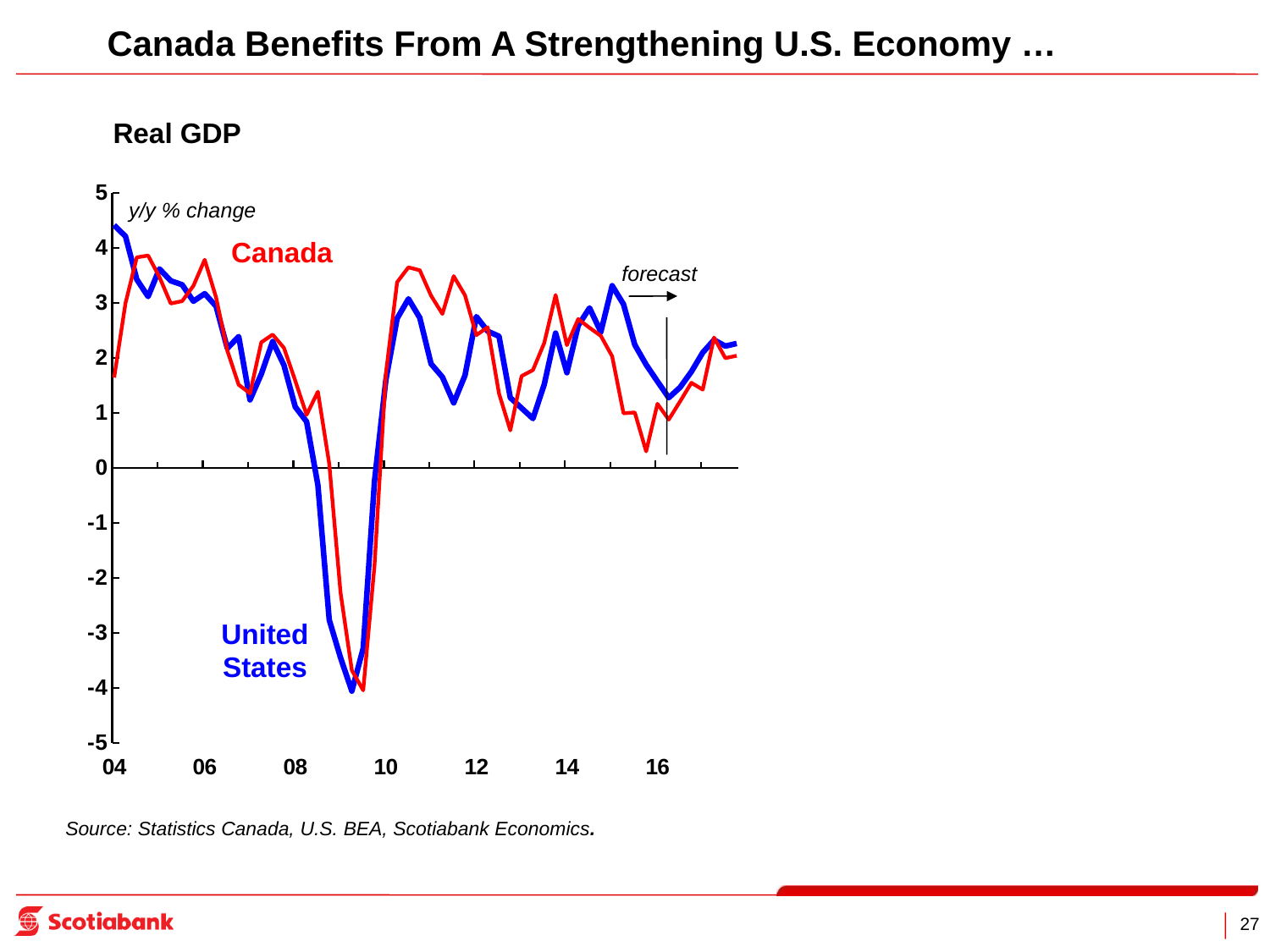
How many series are plotted on the Real GDP chart? 2 At the start of 2004, which series has the higher value, Canada or United States? United States Is the lowest United States value, reached around 2009, greater or less than -3? less What kind of chart is shown on the slide? line chart How many year labels are shown on the x axis? 7 Is the Canada value at the start of 2004 greater or less than 2? less Do both series rise or fall between 2008 and 2009? fall Is the United States value at the start of 2004 greater or less than 4? greater What is the title of the chart? Real GDP Around the middle of 2010, which series has the higher value, Canada or United States? Canada What unit is the y axis of the chart measured in? y/y % change